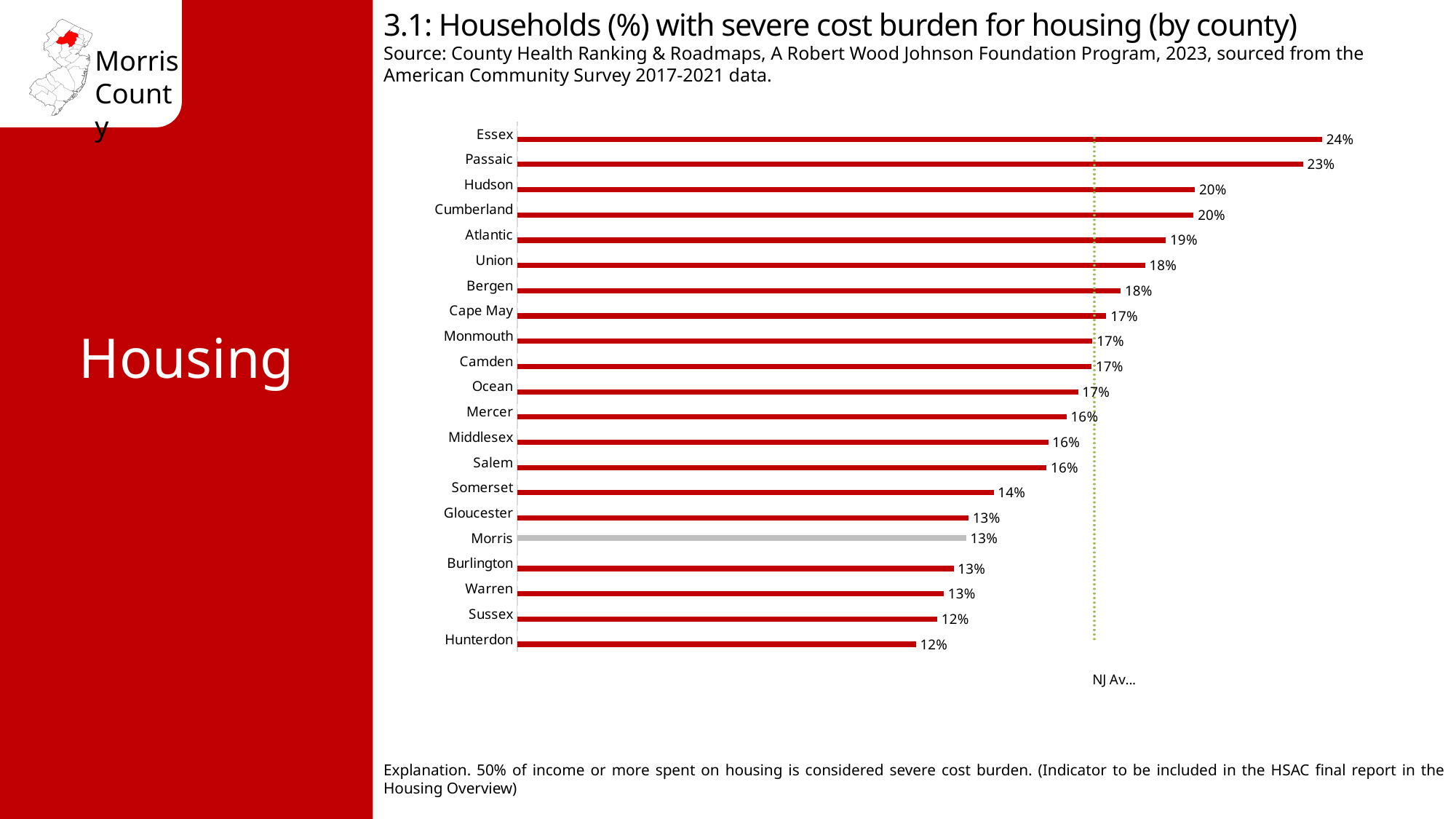
What is the value for Essex? 24% What is the value for Atlantic? 19% What is the difference between the values for Essex and Morris? 11% Which county has the highest percentage of households with severe cost burden? Essex What is the value for Morris? 13% Which county's bar is shown in grey instead of red? Morris Which has a larger value, Hudson or Union? Hudson Which has a larger value, Somerset or Mercer? Mercer What is the difference between the values for Passaic and Hunterdon? 11% How many counties are shown in the chart? 21 What is the value for Somerset? 14% What type of chart is shown on the slide? Bar chart